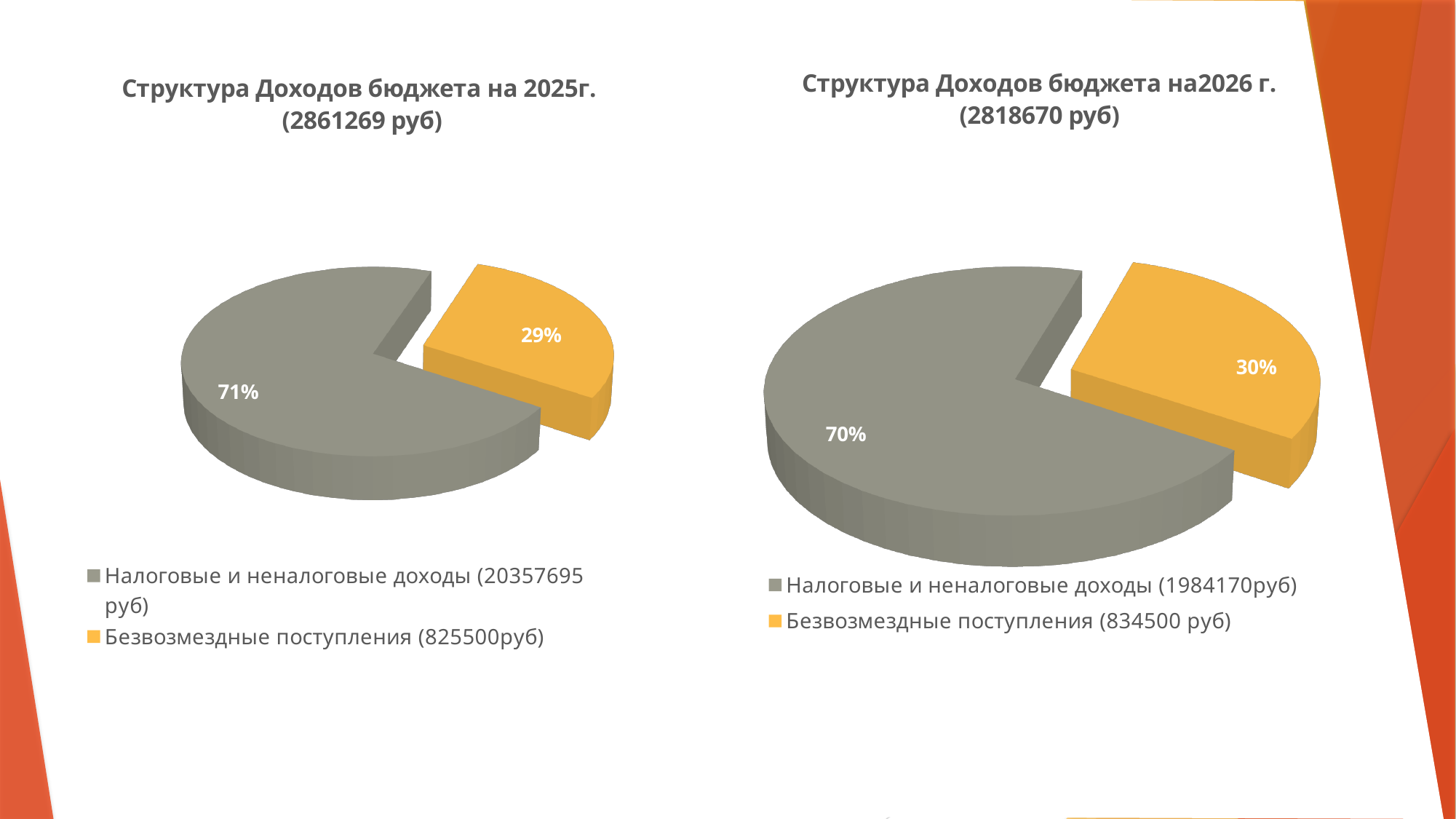
In the right chart (2026), which category has the smallest share? Безвозмездные поступления In the left chart (2025), is the share for Безвозмездные поступления larger or smaller than the share for Налоговые и неналоговые доходы? Smaller In the chart titled "Структура Доходов бюджета на 2025г.", what percentage is shown for Безвозмездные поступления? 29% How many categories does the legend of the right chart (2026) list? 2 In the chart titled "Структура Доходов бюджета на2026 г.", what percentage is shown for Безвозмездные поступления? 30% In the chart titled "Структура Доходов бюджета на 2025г.", what percentage is shown for Налоговые и неналоговые доходы? 71% In the left chart (2025), what is the difference in percentage points between the two slices? 42 What total amount in rubles is given in the title of the right chart for 2026? 2818670 руб In the chart titled "Структура Доходов бюджета на2026 г.", what percentage is shown for Налоговые и неналоговые доходы? 70% In the right chart (2026), what is the difference in percentage points between the two slices? 40 What type of chart is used on the left side of the slide for 2025? Pie chart In the left chart (2025), which category has the largest share? Налоговые и неналоговые доходы